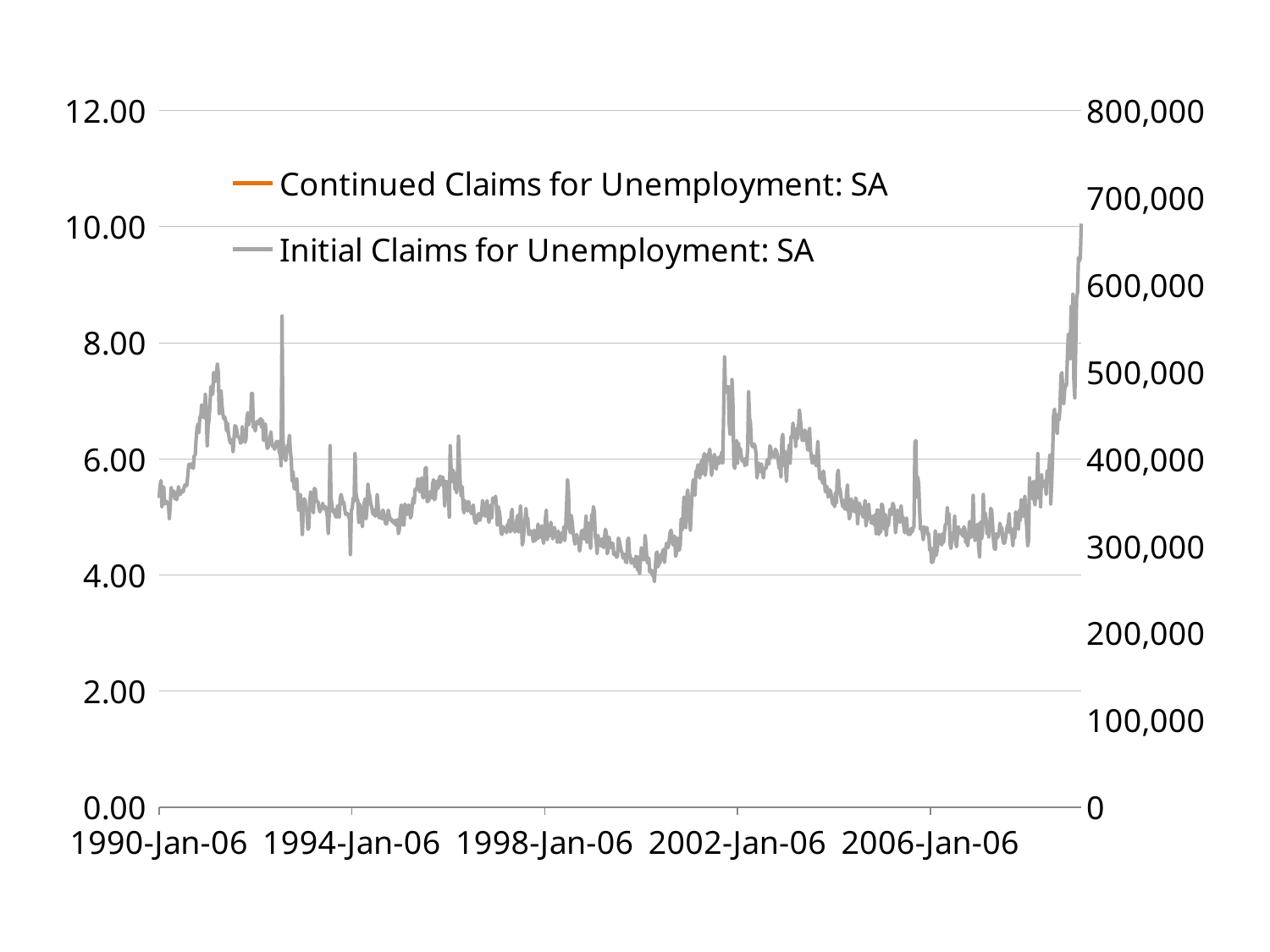
Measured on the right-hand axis, is the lowest point of the Initial Claims for Unemployment: SA line, around 2000, greater or less than 300,000? less What is the first label shown on the x axis? 1990-Jan-06 What colour is the legend marker for "Continued Claims for Unemployment: SA"? orange Does the Initial Claims for Unemployment: SA line rise or fall over the final stretch of the chart, after the 2006-Jan-06 label? rise How many date labels are shown along the x axis? 5 How many series does the legend list? 2 Does the Initial Claims for Unemployment: SA line generally rise or fall between the 1994-Jan-06 and 1998-Jan-06 labels? fall Measured on the right-hand axis, is the value of the Initial Claims for Unemployment: SA line at the 2002-Jan-06 label greater or less than 300,000? greater What kind of chart is shown on the slide? line chart Measured on the right-hand axis, is the value of the Initial Claims for Unemployment: SA line at its final peak on the far right greater or less than 600,000? greater